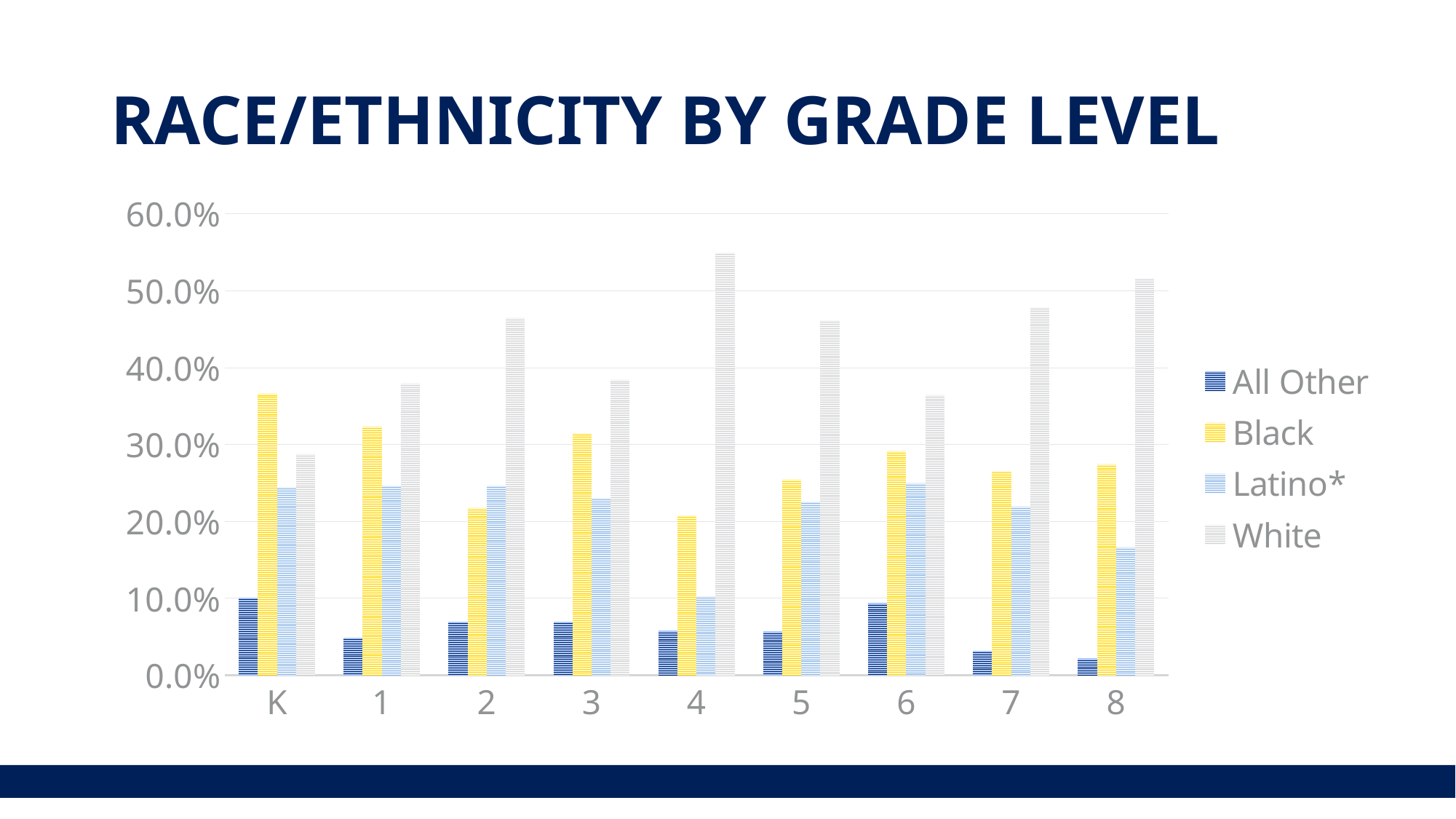
Which grade level has the lowest All Other value? 8 How many grade levels are shown on the x axis? 9 Is the Latino* value for grade 4 greater or less than 20.0%? less Which grade level has the highest White value? 4 Is the White value for grade 4 greater or less than 50.0%? greater At grade K, which is larger: the Black value or the White value? Black Is the Black value for grade K greater or less than 30.0%? greater At grade 8, which is larger: the Latino* value or the Black value? Black How many series does the legend list? 4 Which series has the highest value at grade 2? White What are the four series listed in the legend? All Other, Black, Latino*, White What kind of chart is shown on the slide? Bar chart